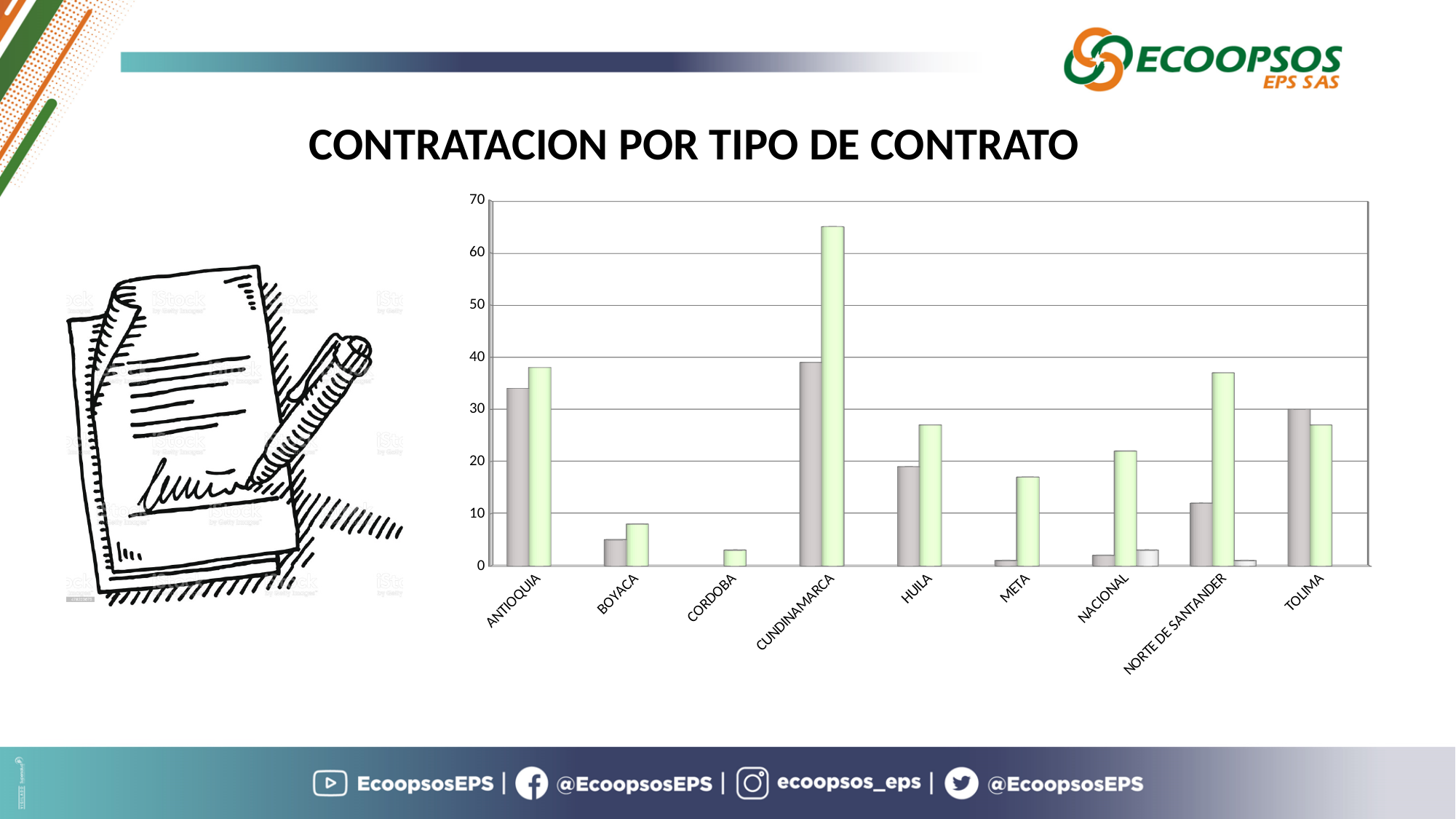
Is the grey bar for ANTIOQUIA greater or less than 30? greater What kind of chart is shown on the slide? bar chart Is the light green bar for META greater or less than 20? less What is the title of the chart? CONTRATACION POR TIPO DE CONTRATO Is the light green bar for NACIONAL greater or less than 10? greater Which category has the shortest light green bar? CORDOBA Which is larger for NORTE DE SANTANDER: the grey bar or the light green bar? the light green bar Which category has the larger light green bar: BOYACA or CORDOBA? BOYACA How many categories are shown on the x axis of the chart? 9 Which category has the tallest bar in the chart? CUNDINAMARCA